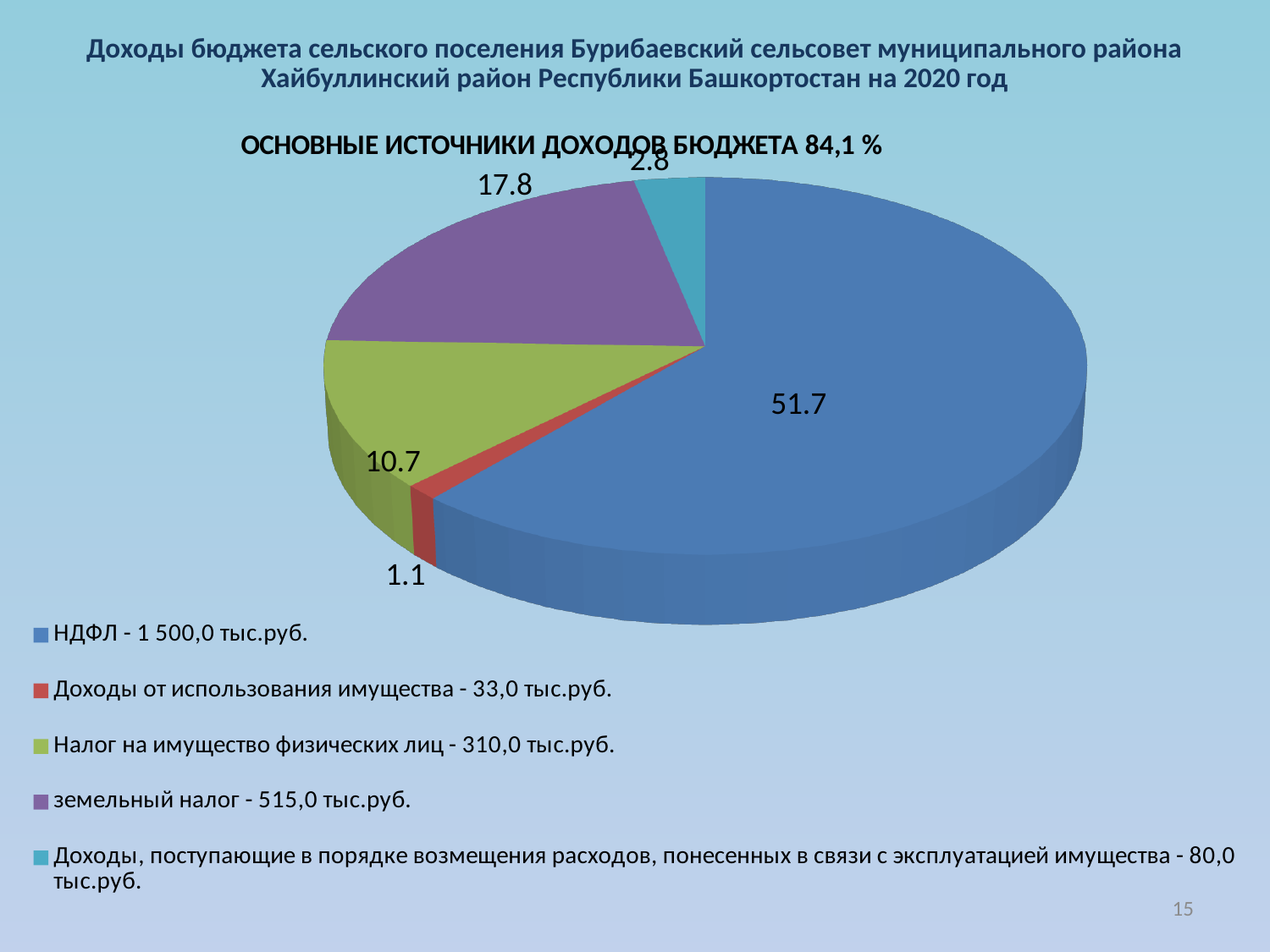
Which category has the smallest slice of the pie? Доходы от использования имущества What kind of chart is shown on the slide? pie chart What is the value shown for the земельный налог slice? 17.8 How many slices does the pie chart have? 5 What is the value shown for the slice labelled Доходы, поступающие в порядке возмещения расходов, понесенных в связи с эксплуатацией имущества? 2.8 Which is larger, the value for земельный налог or the value for Налог на имущество физических лиц? земельный налог What is the value shown for the Доходы от использования имущества slice? 1.1 Which category has the largest slice of the pie? НДФЛ What is the title of the pie chart? ОСНОВНЫЕ ИСТОЧНИКИ ДОХОДОВ БЮДЖЕТА 84,1 % What is the difference between the values for НДФЛ and земельный налог? 33.9 What is the value shown for the НДФЛ slice? 51.7 What is the value shown for the Налог на имущество физических лиц slice? 10.7